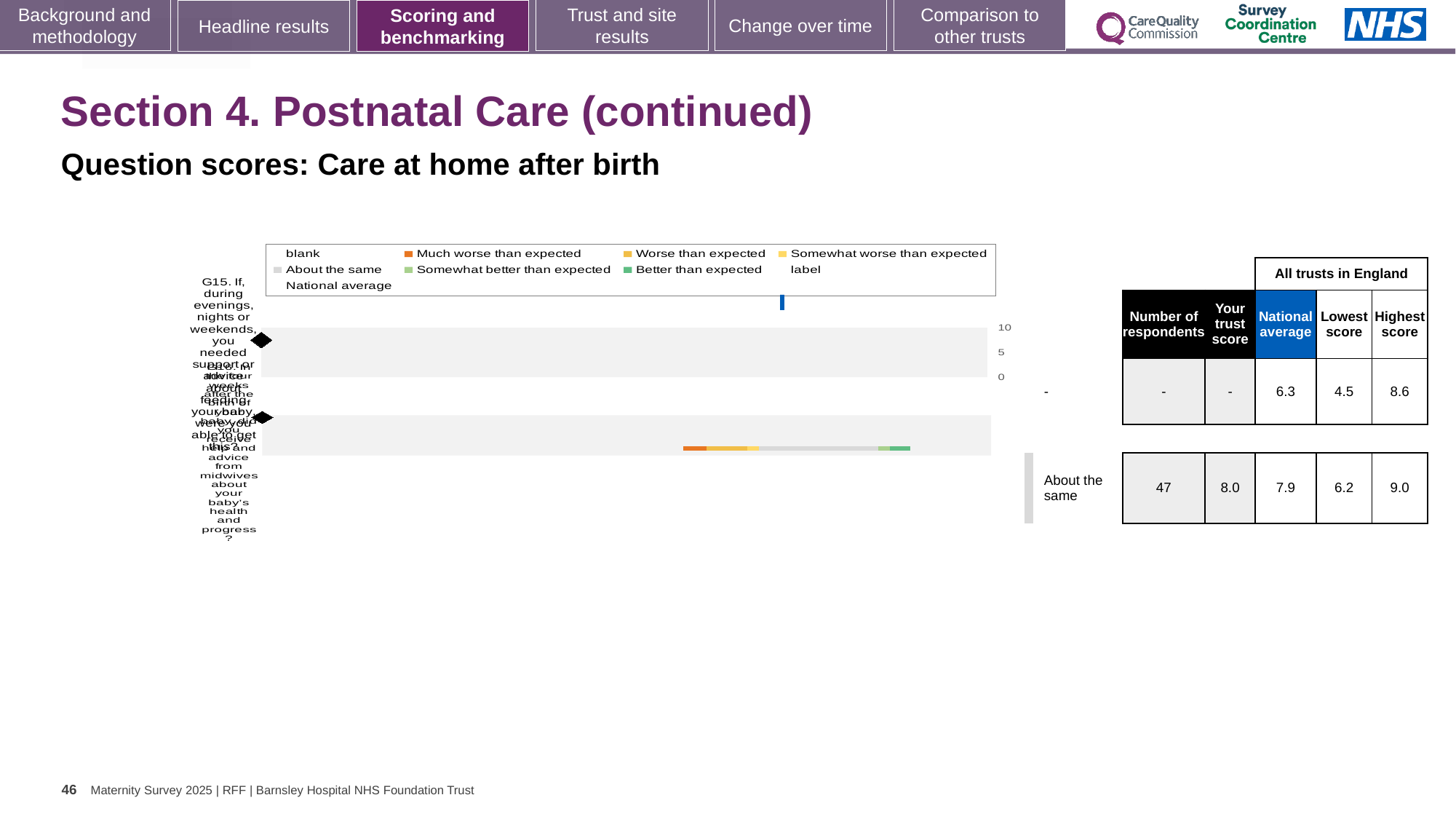
In the table on the right, for the row labelled 'About the same', which is larger: 'Your trust score' or the national average? Your trust score In the table on the right, what is the highest score for the row labelled 'About the same'? 9.0 What kind of chart is shown on the slide? bar chart In the table on the right, what is 'Your trust score' for the row labelled 'About the same'? 8.0 In the table on the right, how many respondents are listed for the row labelled 'About the same'? 47 In the table on the right, what is the difference between the highest score and the lowest score for the row labelled 'About the same'? 2.8 In the table on the right, what is the lowest score for the row labelled 'About the same'? 6.2 In the table on the right, what is the highest score for the first (top) row? 8.6 In the table on the right, what is the difference between the highest score and the lowest score for the first (top) row? 4.1 What is the highest tick value shown on the chart's numeric axis? 10 In the table on the right, what is the national average for the first (top) row? 6.3 In the table on the right, what is the national average for the row labelled 'About the same'? 7.9